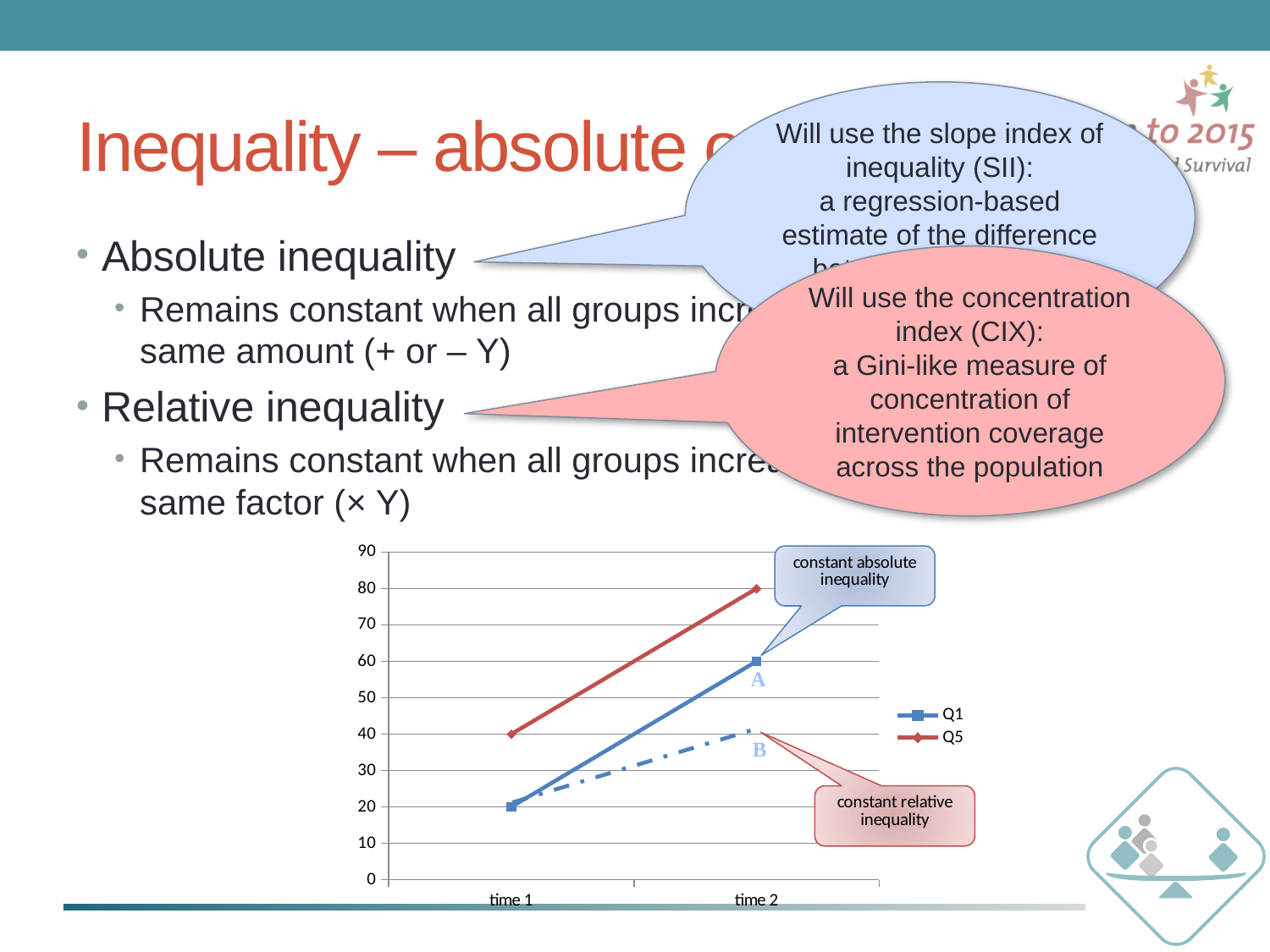
What is the difference between Q5 and Q1 at time 1? 20 Is the value of Q5 at time 2 greater or less than 70? greater Which series has the higher value at time 2? Q5 How many series does the chart legend list? 2 What is the value of Q1 at time 1? 20 What is the value of Q1 at time 2 (point A)? 60 What kind of chart is shown on the slide? line chart Does the Q1 series rise or fall from time 1 to time 2? rise How many time points are shown on the x axis of the chart? 2 What is the value of Q5 at time 2? 80 Which series are listed in the chart legend? Q1 and Q5 What is the value of Q5 at time 1? 40